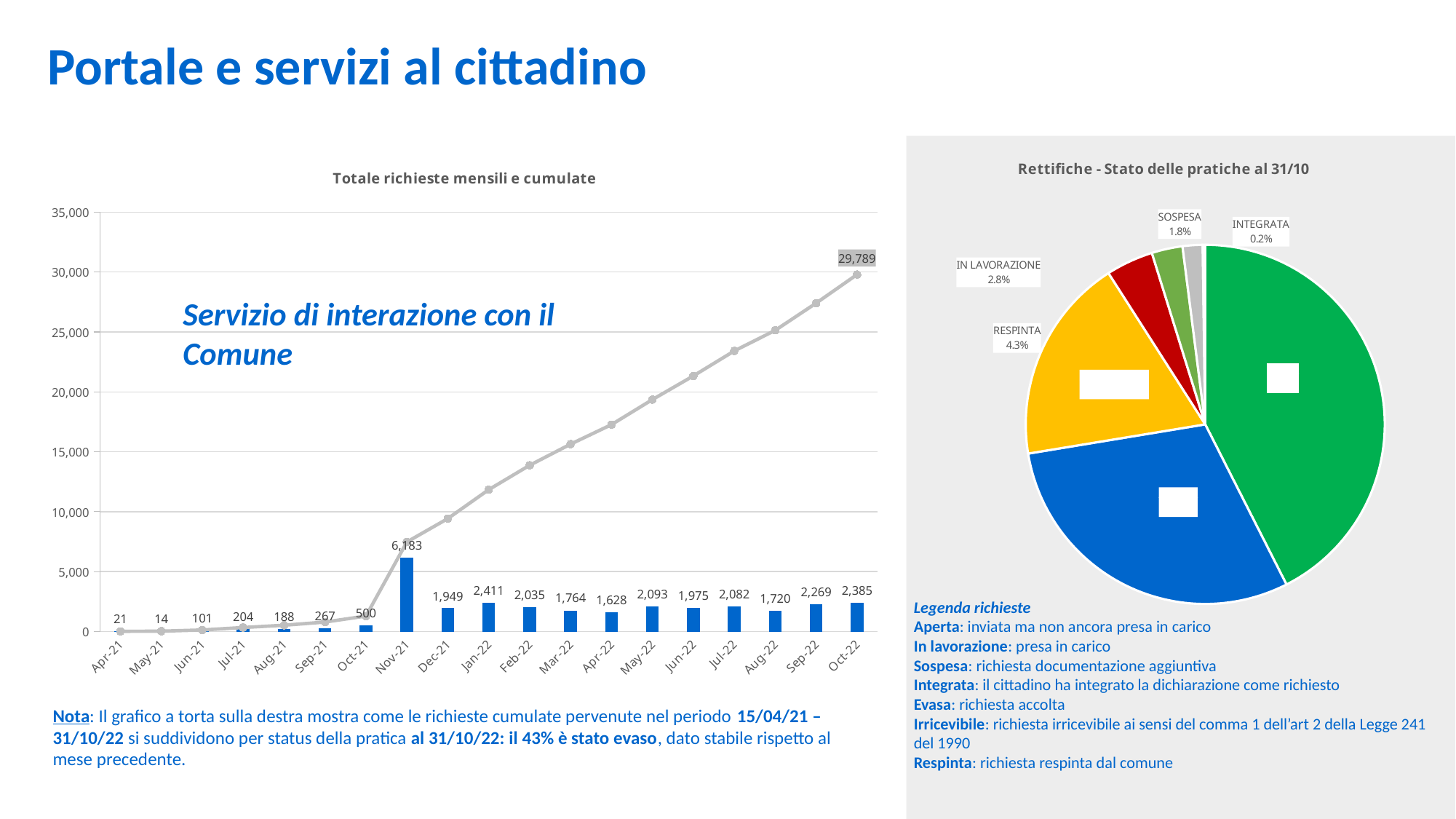
In the chart 'Totale richieste mensili e cumulate', which month has the lowest bar? May-21 How many months are shown on the x axis of the chart 'Totale richieste mensili e cumulate'? 19 In the chart 'Totale richieste mensili e cumulate', what is the value of the bar for Oct-22? 2,385 In the chart 'Totale richieste mensili e cumulate', which month has the highest bar? Nov-21 In the chart 'Totale richieste mensili e cumulate', does the cumulative line rise or fall from Apr-21 to Oct-22? rises In the chart 'Totale richieste mensili e cumulate', what is the cumulative value labelled at Oct-22? 29,789 In the pie chart 'Rettifiche - Stato delle pratiche al 31/10', what share is labelled for RESPINTA? 4.3% In the pie chart 'Rettifiche - Stato delle pratiche al 31/10', what share is labelled for IN LAVORAZIONE? 2.8% In the chart 'Totale richieste mensili e cumulate', what is the difference between the bars for Oct-22 and Sep-22? 116 In the chart 'Totale richieste mensili e cumulate', is the cumulative line value at Jan-22 greater or less than 10,000? greater In the chart 'Totale richieste mensili e cumulate', what is the value of the bar for Nov-21? 6,183 In the chart 'Totale richieste mensili e cumulate', which bar is larger, Dec-21 or Jan-22? Jan-22